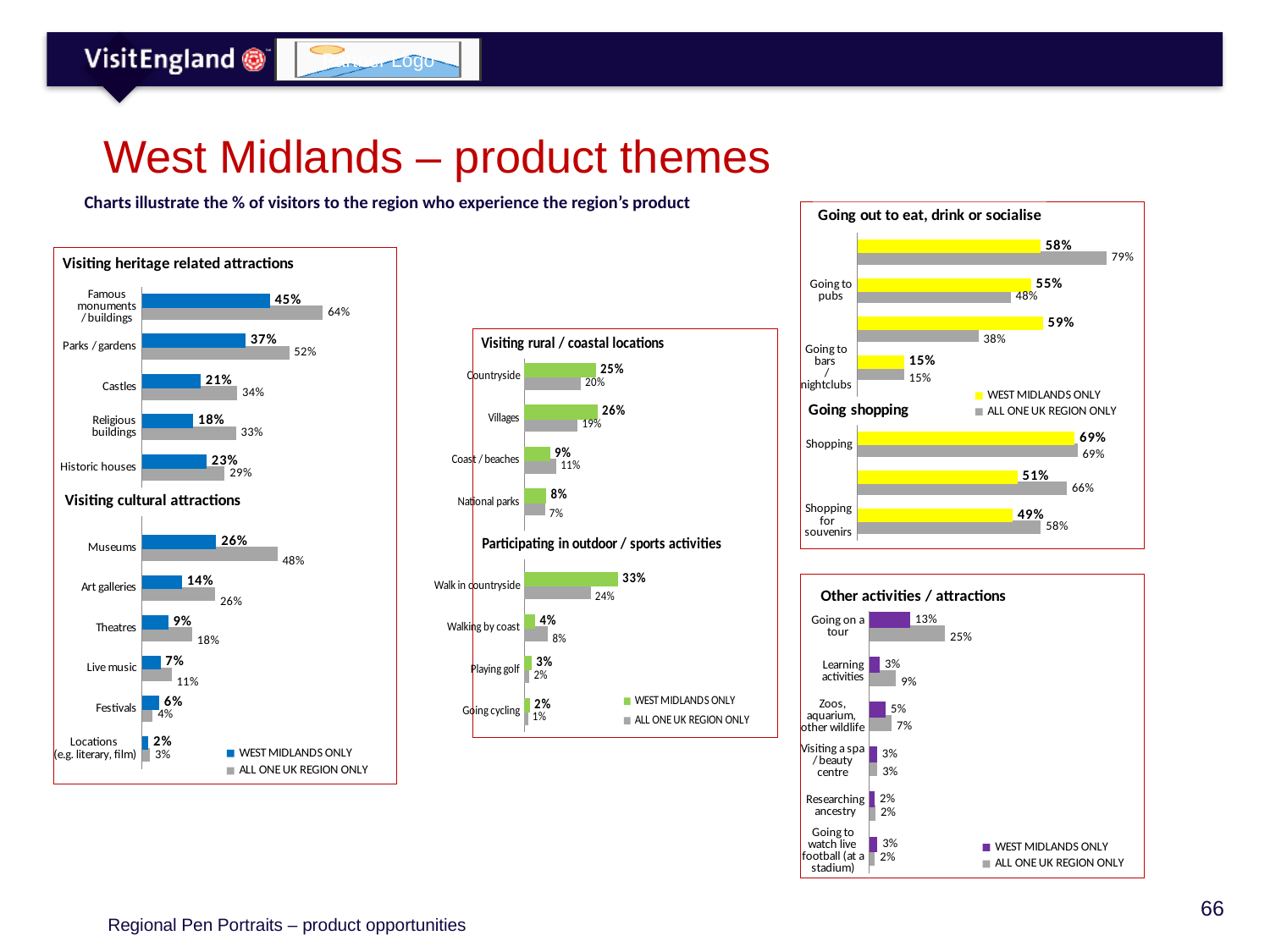
In the 'Visiting heritage related attractions' chart, what is the West Midlands only value for Castles? 21% In the 'Visiting cultural attractions' chart, which category has the highest West Midlands only value? Museums In the 'Participating in outdoor / sports activities' chart, what is the West Midlands only value for Walk in countryside? 33% In the 'Visiting rural / coastal locations' chart, how many categories are shown? 4 In the 'Visiting rural / coastal locations' chart, what is the West Midlands only value for Villages? 26% In the 'Participating in outdoor / sports activities' chart, which is larger for Walking by coast: the West Midlands only value or the All one UK region only value? All one UK region only In the 'Other activities / attractions' chart, which category has the lowest West Midlands only value? Researching ancestry In the 'Going out to eat, drink or socialise' chart, what is the All one UK region only value for Going to pubs? 48% In the 'Visiting cultural attractions' chart, what is the difference between the All one UK region only and West Midlands only values for Museums? 22% In the 'Visiting heritage related attractions' chart, what is the All one UK region only value for Famous monuments / buildings? 64% In the 'Going shopping' chart, what is the West Midlands only value for Shopping for souvenirs? 49% How many series does the legend of the 'Other activities / attractions' chart list? 2